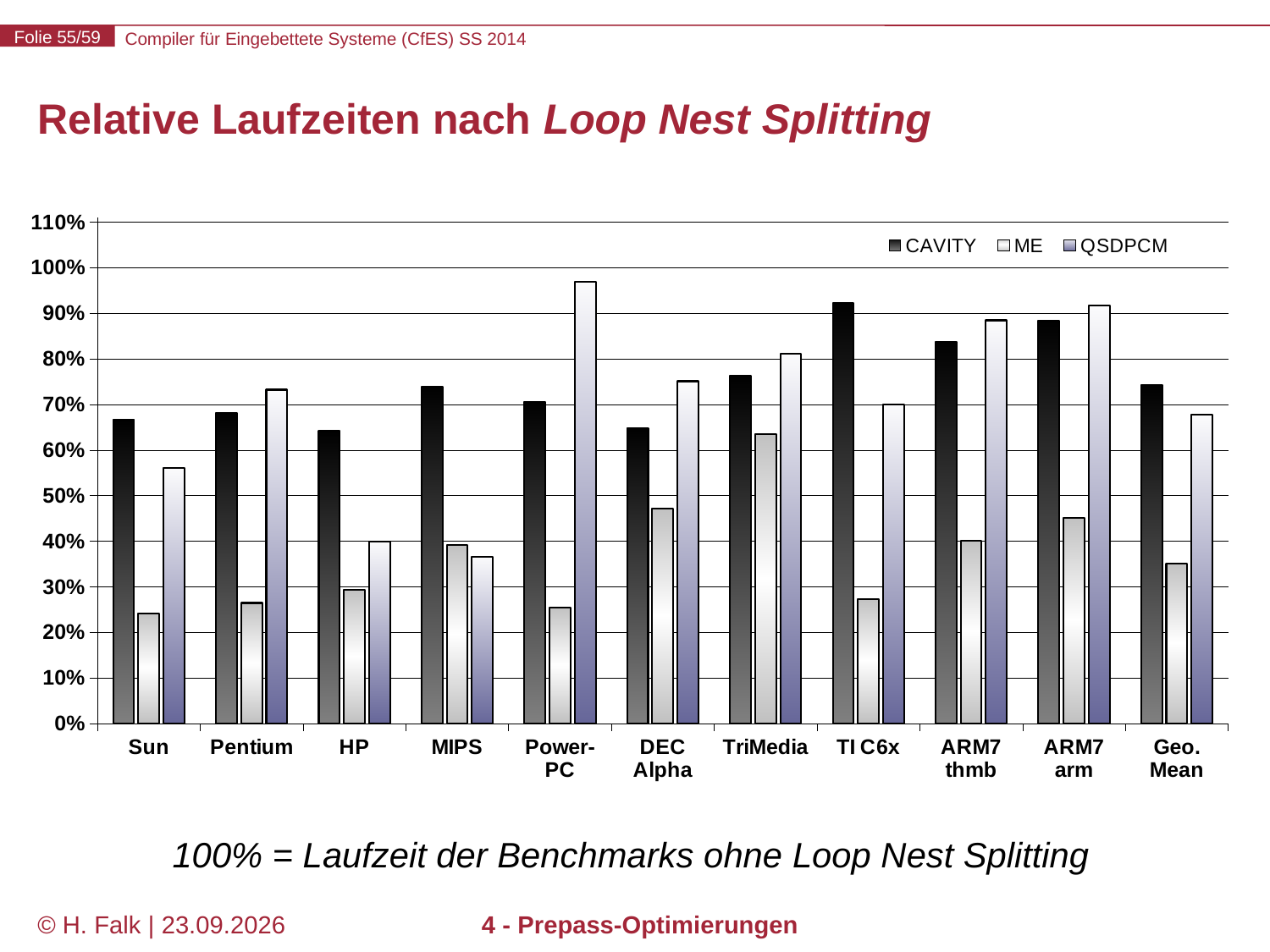
How many categories are shown on the x axis? 11 Is the ME value for Geo. Mean greater or less than 40%? less Is the QSDPCM value for Power-PC greater or less than 90%? greater How many series does the legend list? 3 For Sun, which is larger: the CAVITY value or the QSDPCM value? CAVITY Which category has the highest QSDPCM value? Power-PC What are the three series named in the legend? CAVITY, ME, QSDPCM Which category has the highest CAVITY value? TI C6x Which category has the lowest QSDPCM value? MIPS Is the ME value for Sun greater or less than 30%? less What kind of chart is shown on the slide? bar chart For TriMedia, which is larger: the ME value or the QSDPCM value? QSDPCM